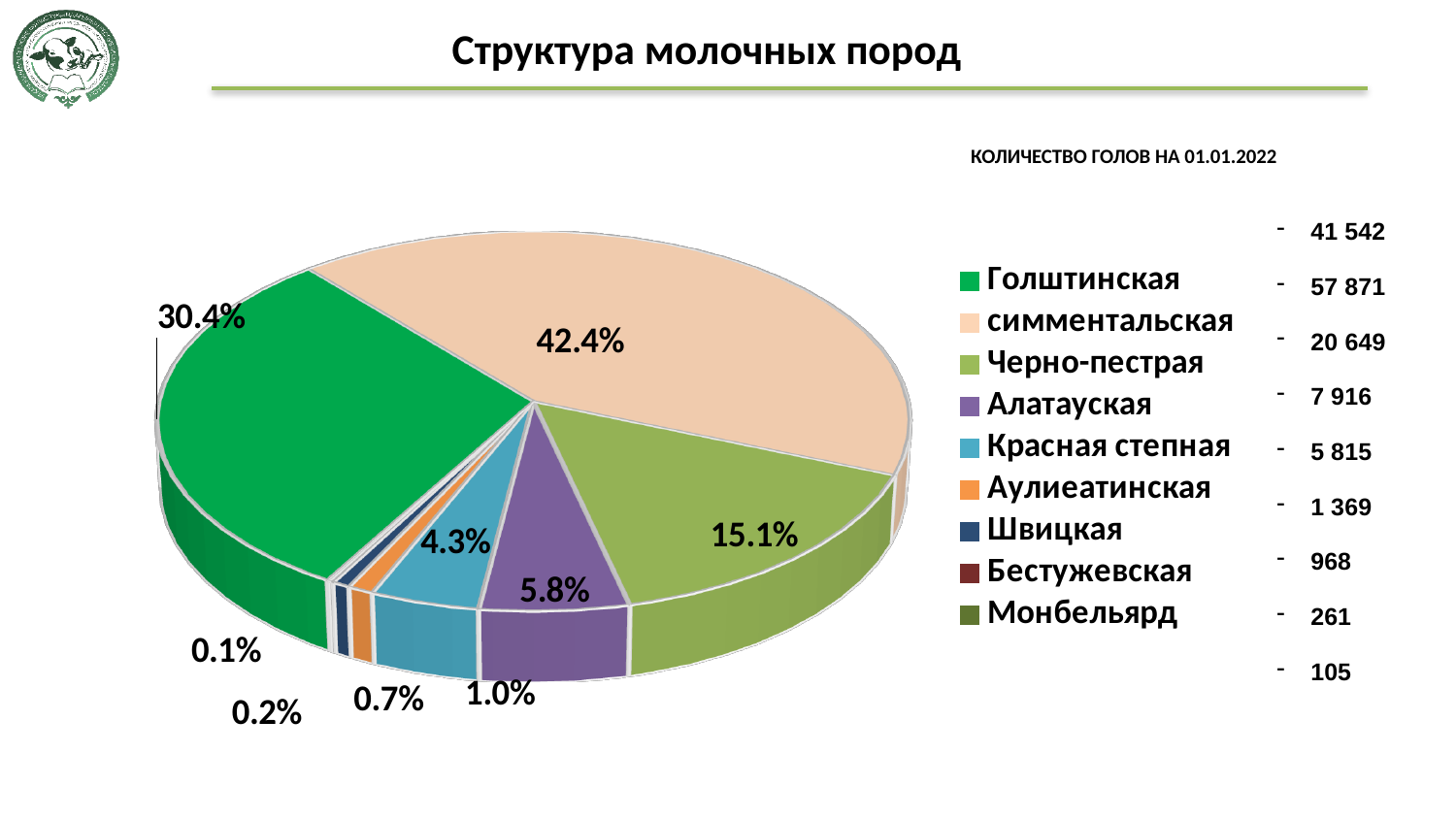
What share of the pie does Алатауская have? 5.8% What share of the pie does Черно-пестрая have? 15.1% What is the difference between the shares of симментальская and Голштинская? 12.0% Which slice is larger, Голштинская or Черно-пестрая? Голштинская What is the title of the chart? Структура молочных пород How many breeds (slices) does the pie chart show? 9 Which breed has the smallest slice of the pie? Монбельярд What share of the pie does Голштинская have? 30.4% Which breed has the largest slice of the pie? симментальская What kind of chart is shown on the slide? pie chart